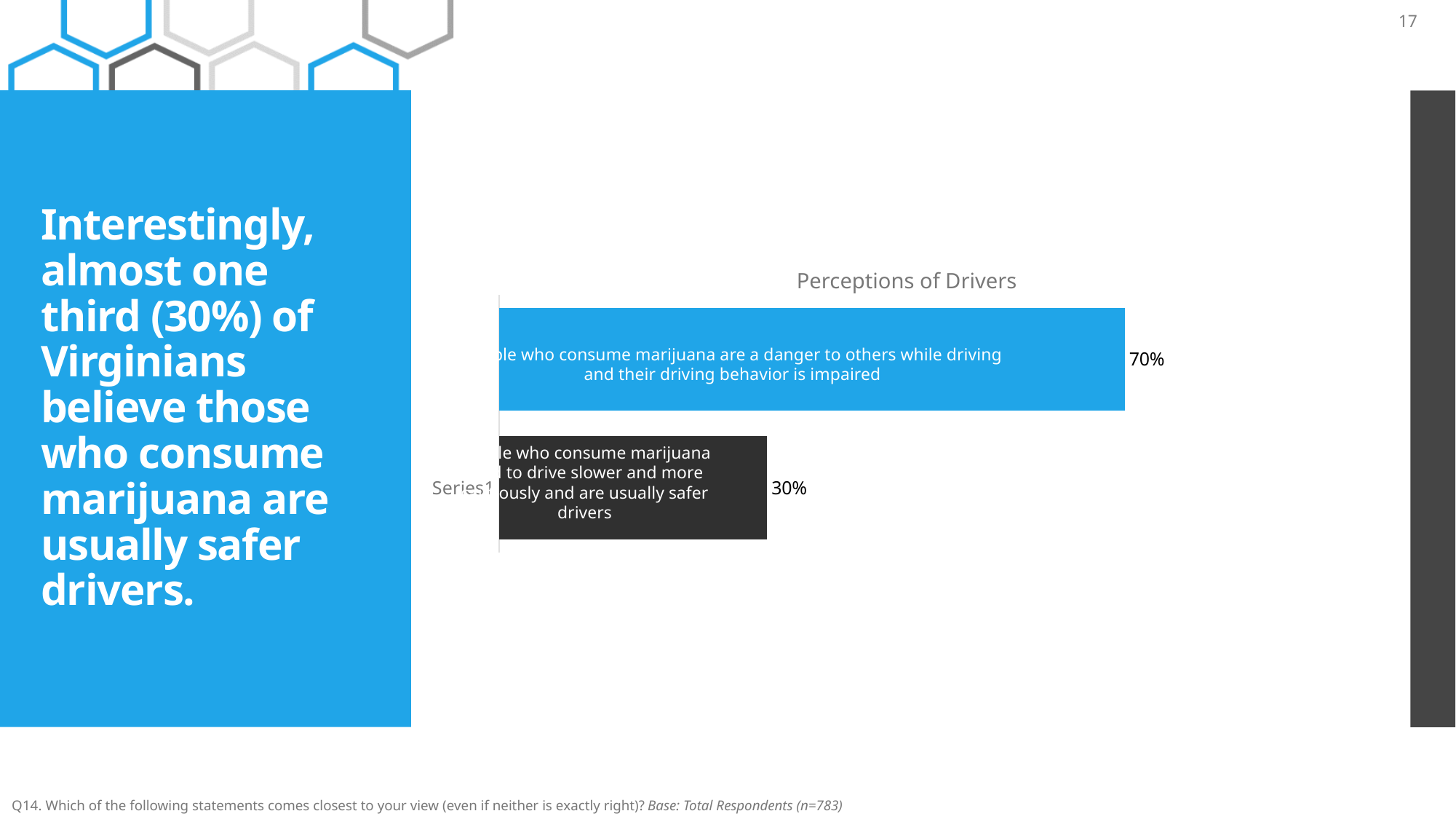
What percentage of respondents believe people who consume marijuana are a danger to others while driving and their driving behavior is impaired? 70% How many bars are plotted in the chart? 2 What colour is the bar for the statement that marijuana consumers are a danger to others while driving? Blue What is the total of the two percentages shown in the chart? 100% What is the title of the chart? Perceptions of Drivers What is the base (number of respondents) noted at the bottom of the slide? n=783 What is the difference in percentage points between the two statements in the chart? 40 percentage points Is the value for the 'usually safer drivers' statement larger or smaller than the value for the 'danger to others' statement? Smaller What kind of chart is shown on the slide? Bar chart Which statement has the lowest share of respondents in the chart? People who consume marijuana drive slower and are usually safer drivers Which statement has the higher share of respondents: that marijuana consumers are a danger to others while driving, or that they are usually safer drivers? A danger to others while driving What percentage of respondents believe people who consume marijuana drive slower and more cautiously and are usually safer drivers? 30%